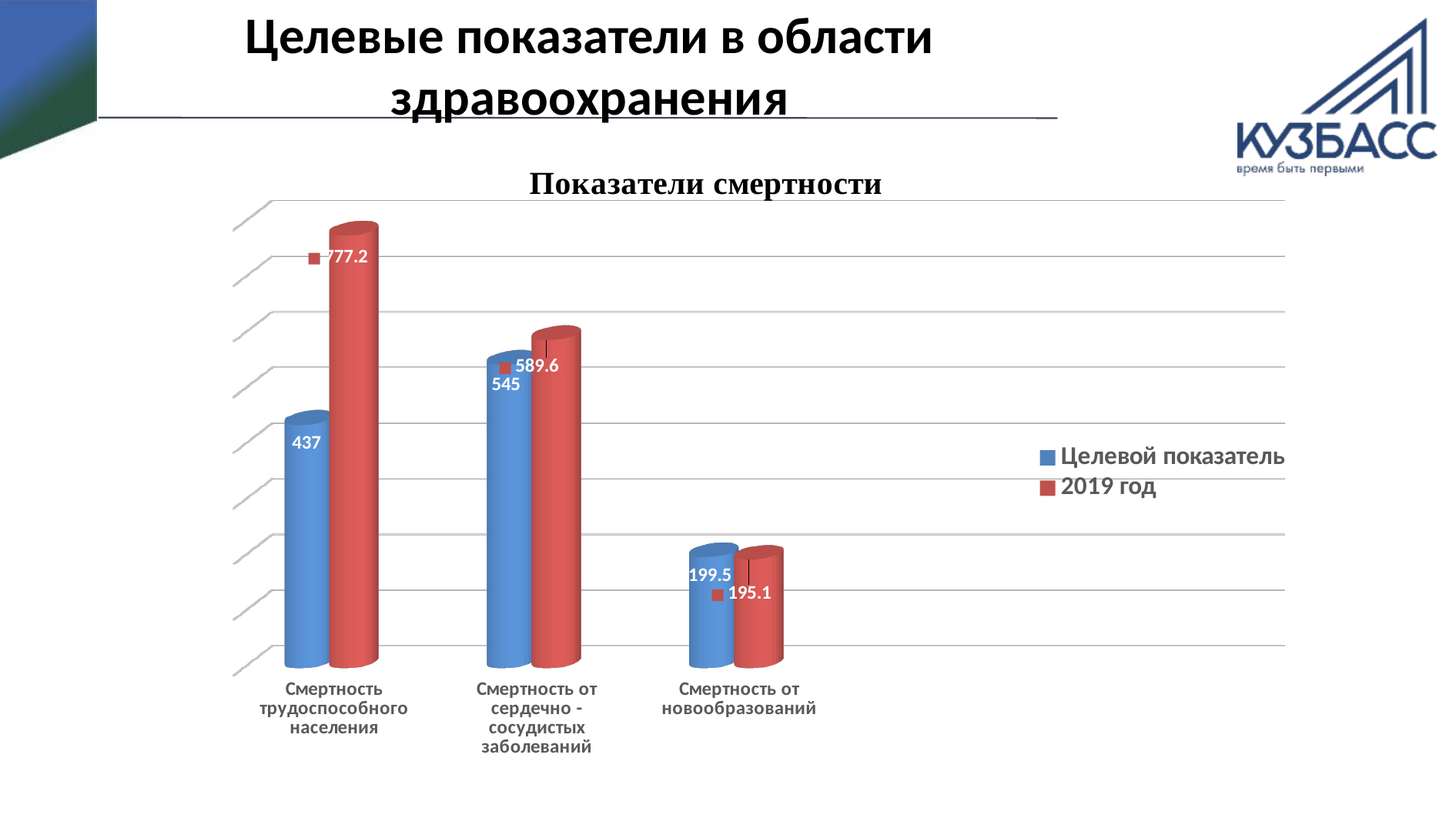
For Смертность от новообразований, which is larger: the Целевой показатель value or the 2019 год value? Целевой показатель What is the 2019 год value for Смертность от новообразований? 195.1 Which category has the highest 2019 год value? Смертность трудоспособного населения What is the difference between the 2019 год value and the Целевой показатель value for Смертность трудоспособного населения? 340.2 Which category has the lowest Целевой показатель value? Смертность от новообразований What is the Целевой показатель value for Смертность от сердечно-сосудистых заболеваний? 545 How many categories are shown on the x axis of the chart? 3 What is the value of the 2019 год series for Смертность трудоспособного населения? 777.2 What is the difference between the 2019 год value and the Целевой показатель value for Смертность от сердечно-сосудистых заболеваний? 44.6 How many series does the legend list? 2 What is the title of the chart? Показатели смертности What is the Целевой показатель value for Смертность трудоспособного населения? 437